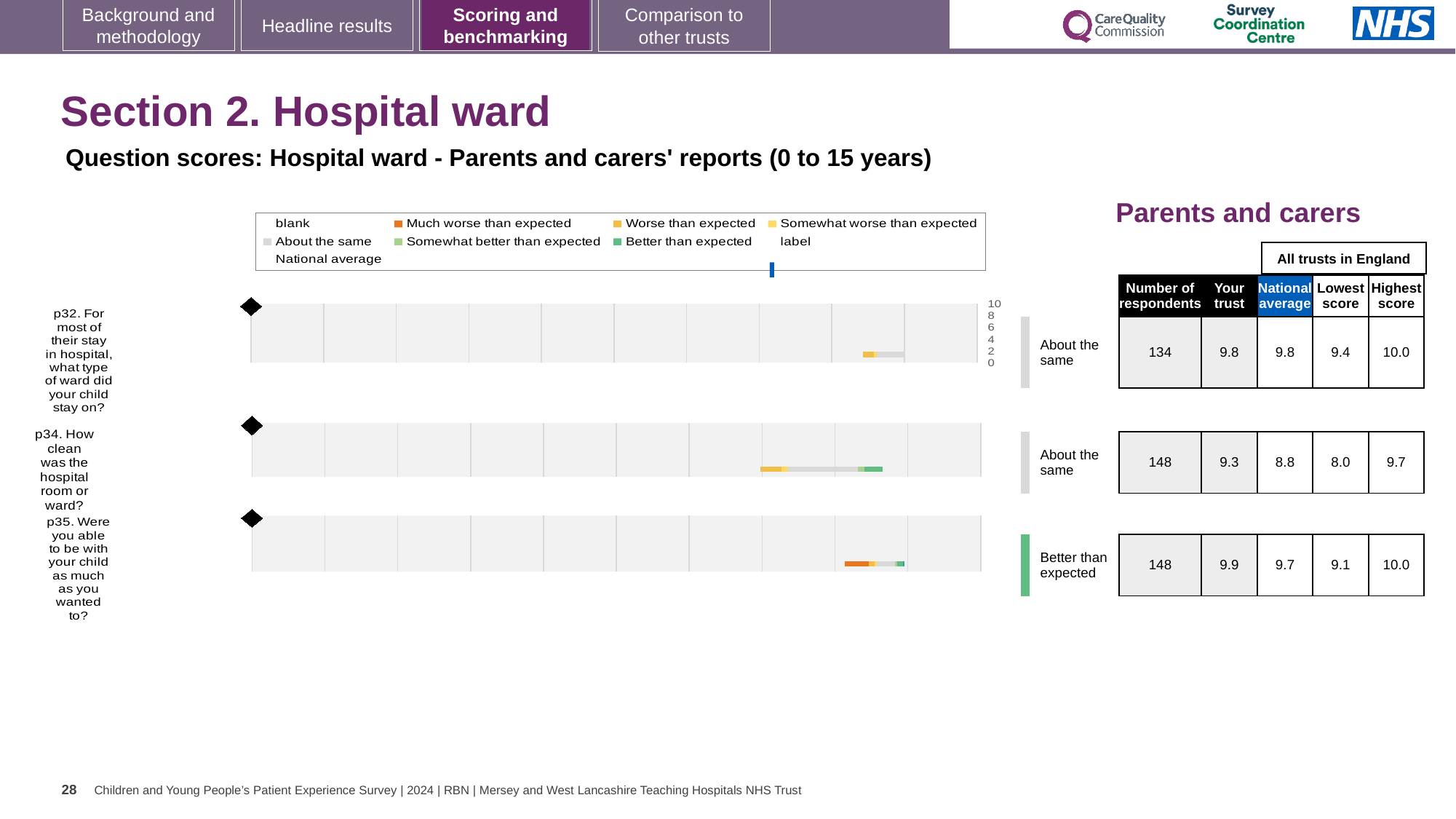
Which question has the lowest 'Lowest score' value among all trusts in England? p34 How many survey questions are plotted on the slide? 3 For p32 (what type of ward did your child stay on), what is the number of respondents? 134 What is the title of the table to the right of the charts? Parents and carers What benchmark category is shown for p35 (were you able to be with your child as much as you wanted to)? Better than expected For p35 (were you able to be with your child as much as you wanted to), what is the lowest score among all trusts in England? 9.1 For p34 (how clean was the hospital room or ward), what is the national average score? 8.8 What kind of chart is used to show the question scores on this slide? bar chart For p34, which is larger: the 'Your trust' score or the national average? Your trust For p34 (how clean was the hospital room or ward), what is the 'Your trust' score? 9.3 Which question has the highest 'Your trust' score? p35 For p34, what is the difference between the 'Your trust' score and the national average? 0.5